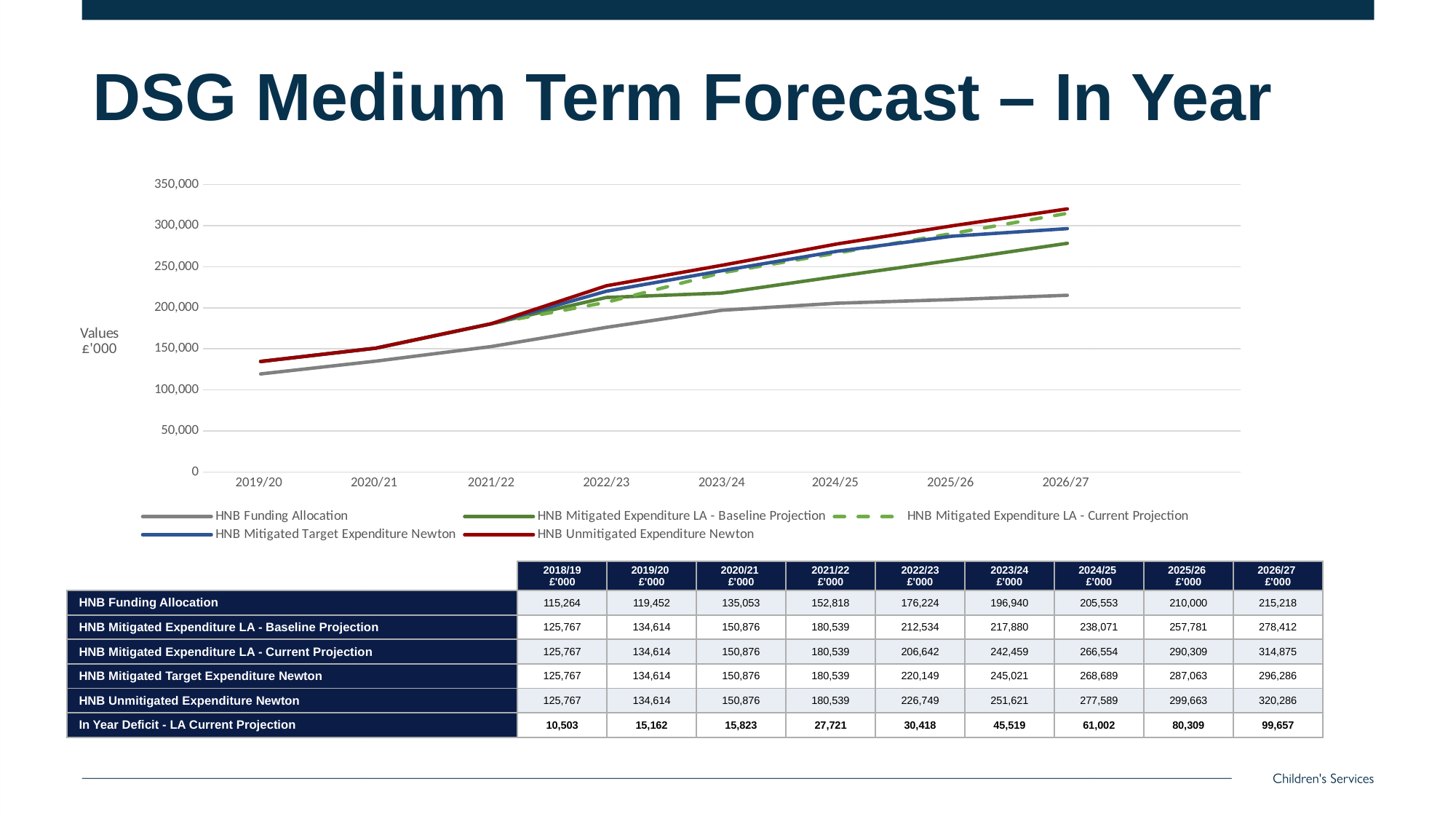
How many series does the chart legend list? 5 Is the value for HNB Unmitigated Expenditure Newton in 2026/27 greater or less than 300,000? greater Which series is highest in 2026/27? HNB Unmitigated Expenditure Newton Using the table values, what is the difference between HNB Unmitigated Expenditure Newton and HNB Funding Allocation in 2026/27? 105,068 Does the HNB Funding Allocation line rise or fall from 2019/20 to 2026/27? rise How many year categories are shown on the chart's x axis? 8 What kind of chart is shown on the slide? line chart Is the value for HNB Funding Allocation in 2026/27 greater or less than 250,000? less Which series is lowest in 2026/27? HNB Funding Allocation In 2023/24, which is larger: HNB Mitigated Expenditure LA - Baseline Projection or HNB Mitigated Expenditure LA - Current Projection? HNB Mitigated Expenditure LA - Current Projection According to the table on the slide, what is the HNB Funding Allocation value for 2026/27? 215,218 What is the label on the chart's vertical axis? Values £'000